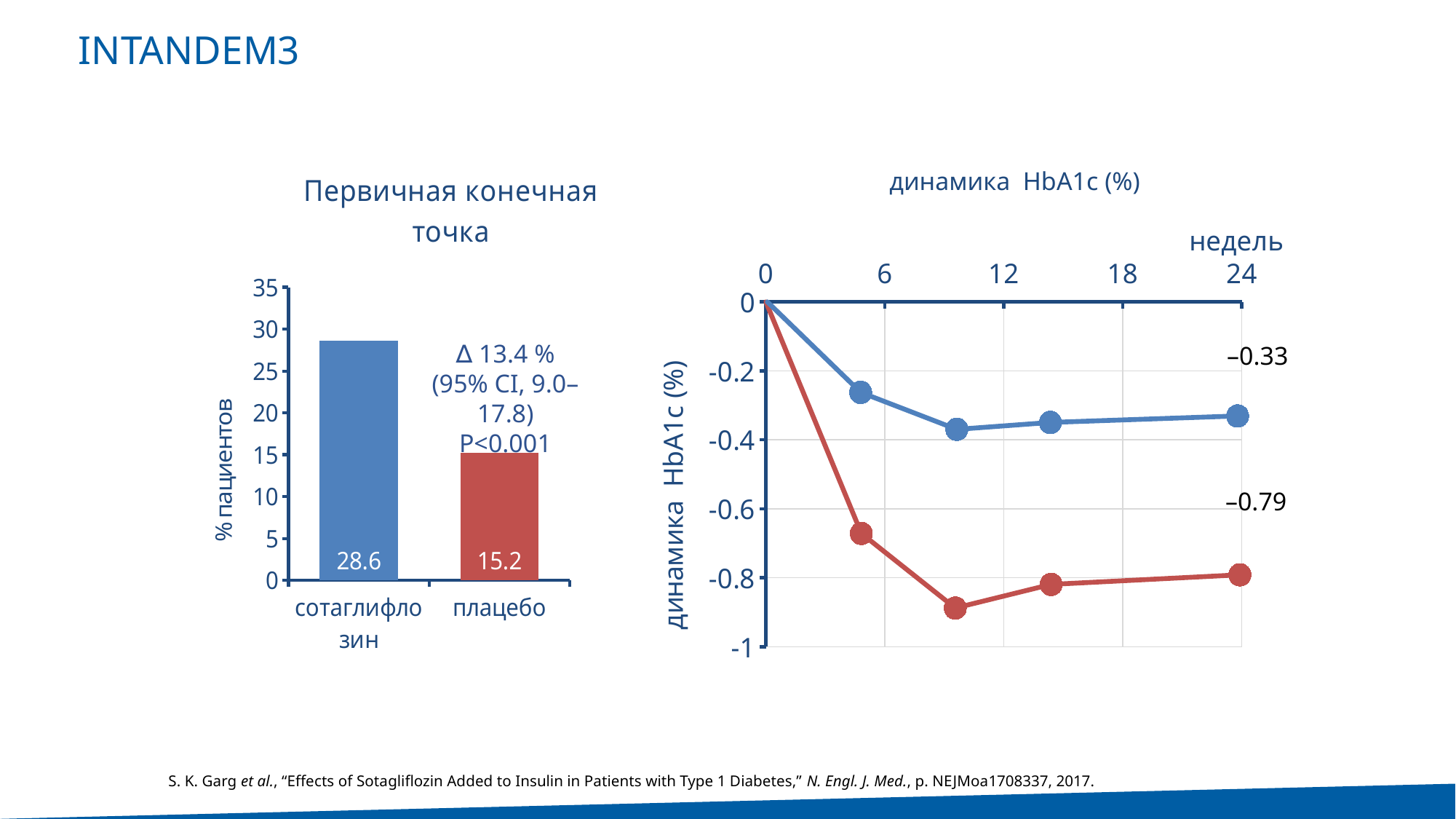
In the chart titled "Первичная конечная точка", is the value for плацебо greater or less than 20? less How many bars are shown in the chart titled "Первичная конечная точка"? 2 In the chart titled "динамика HbA1c (%)", what is the value of the red line at week 24? –0.79 In the chart titled "динамика HbA1c (%)", which line shows the larger decrease in HbA1c at week 24, the blue or the red? red What kind of chart is the chart titled "Первичная конечная точка"? bar chart What kind of chart is the chart titled "динамика HbA1c (%)"? line chart In the chart titled "Первичная конечная точка", what is the difference between the сотаглифлозин and плацебо values? 13.4 In the chart titled "Первичная конечная точка", what is the value for плацебо? 15.2 In the chart titled "Первичная конечная точка", what is the value for сотаглифлозин? 28.6 In the chart titled "динамика HbA1c (%)", what is the value of the blue line at week 24? –0.33 In the chart titled "Первичная конечная точка", which category has the higher value? сотаглифлозин